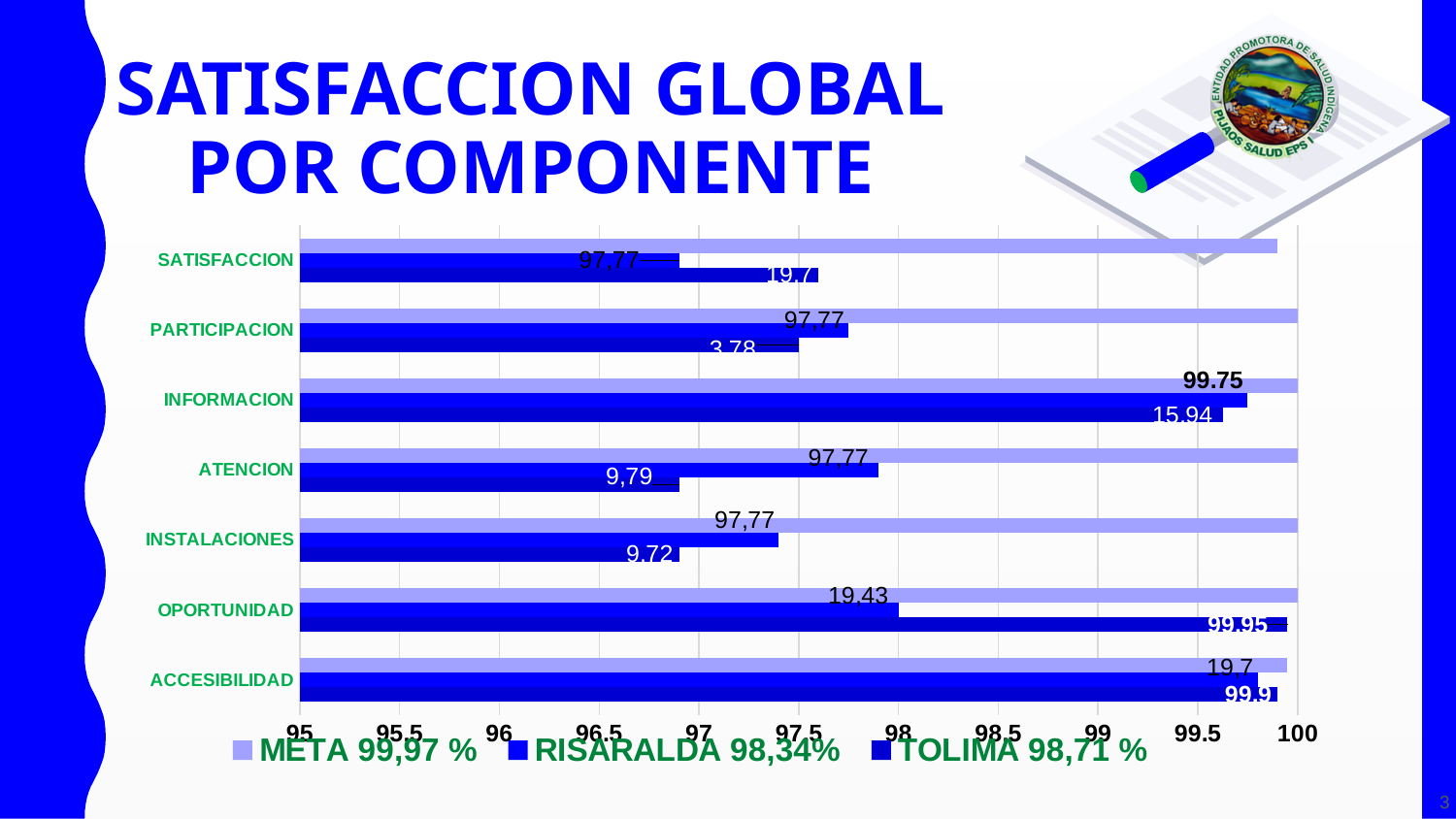
What kind of chart is shown on the slide? bar chart For SATISFACCION, which is larger: the RISARALDA value or the TOLIMA value? TOLIMA What are the three series named in the chart legend? META 99,97 %, RISARALDA 98,34%, TOLIMA 98,71 % Is the TOLIMA value for ATENCION greater or less than 97? less How many components (categories) are listed on the vertical axis of the chart? 7 Is the TOLIMA value for OPORTUNIDAD greater or less than 99.5? greater How many series does the chart legend list? 3 Is the RISARALDA value for ATENCION greater or less than 97.5? greater What is the title of the slide containing the chart? SATISFACCION GLOBAL POR COMPONENTE For ATENCION, which is larger: the RISARALDA value or the TOLIMA value? RISARALDA